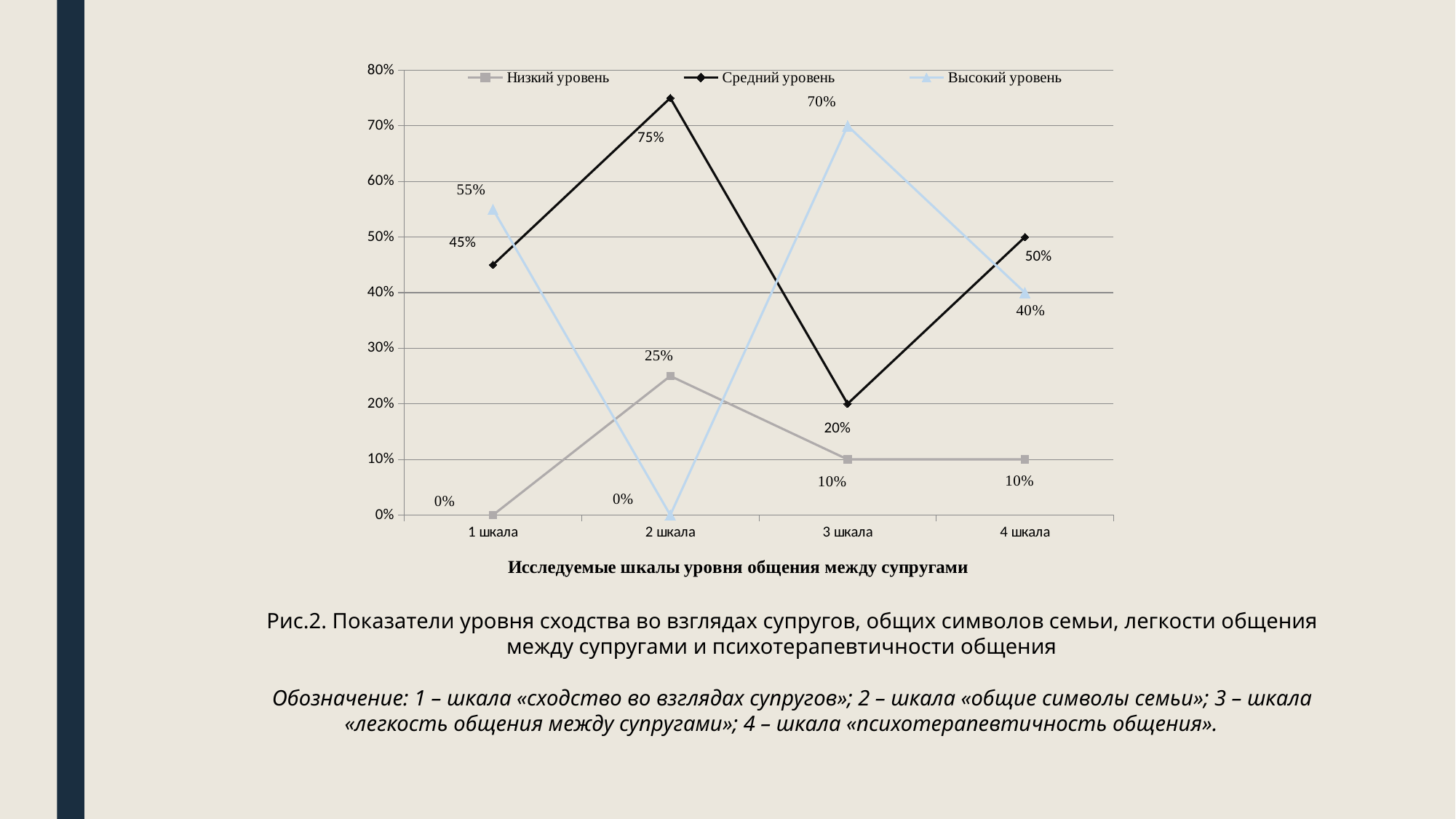
What type of chart is shown on the slide? line chart What is the value of Высокий уровень for 3 шкала? 70% What is the value of Высокий уровень for 4 шкала? 40% How many series does the legend list? 3 Which is larger for 1 шкала: Средний уровень or Высокий уровень? Высокий уровень What is the value of Средний уровень for 2 шкала? 75% What is the value of Низкий уровень for 2 шкала? 25% How many categories are shown on the x axis? 4 What is the x-axis title of the chart? Исследуемые шкалы уровня общения между супругами For which category is Высокий уровень lowest? 2 шкала For which category is Средний уровень highest? 2 шкала What is the difference between Средний уровень and Высокий уровень for 4 шкала? 10%